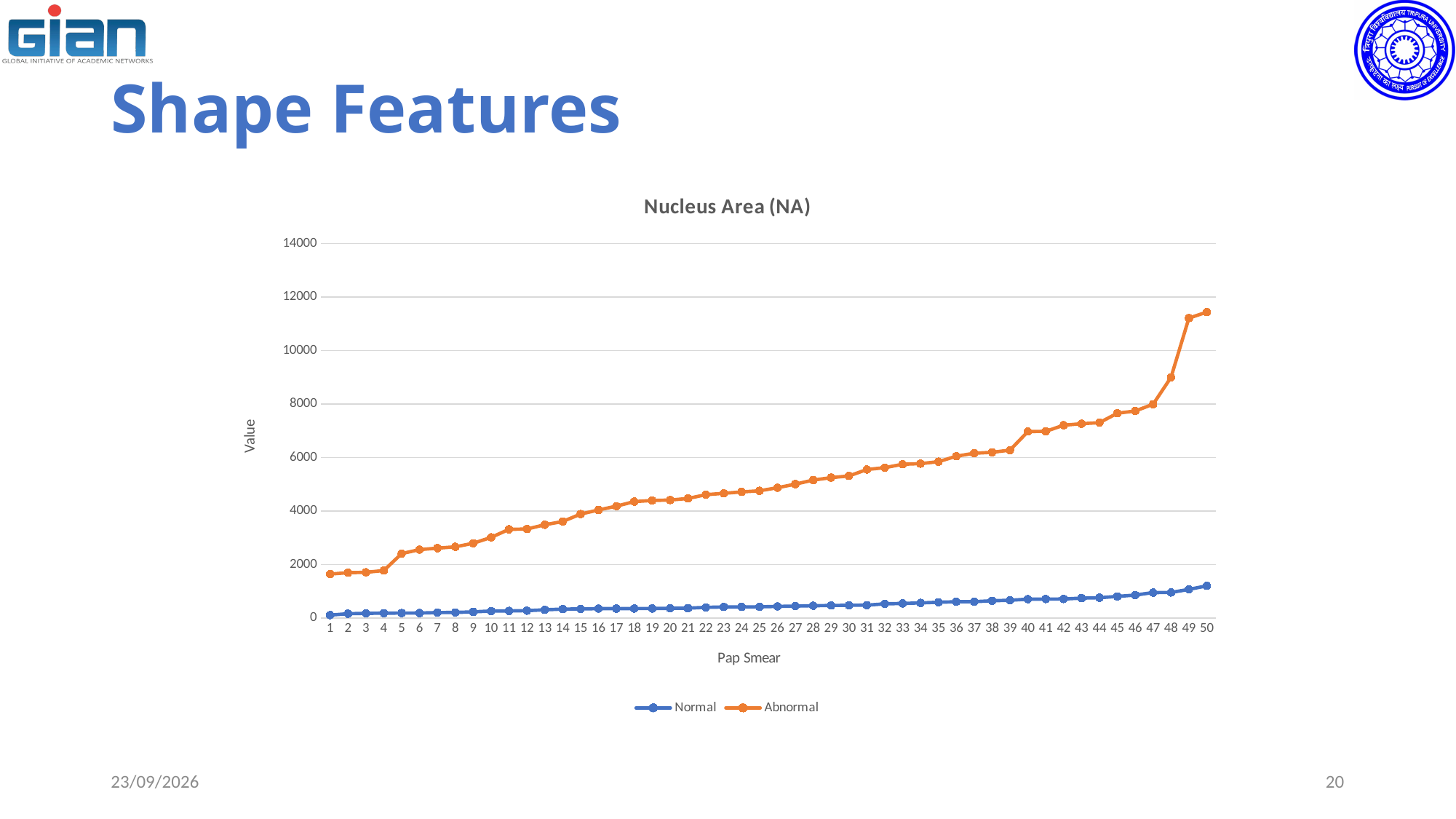
Do the Abnormal values rise or fall as Pap Smear goes from 1 to 50? rise What kind of chart is shown on the slide? line chart At which Pap Smear number is the Normal series lowest? 1 How many series does the legend list? 2 Is the Normal value at Pap Smear 50 greater or less than 2000? less Is the Abnormal value at Pap Smear 1 greater or less than 2000? less Which series has the higher value at Pap Smear 50, Normal or Abnormal? Abnormal How many Pap Smear points are plotted along the x axis? 50 What is the label of the y axis? Value At which Pap Smear number does the Abnormal series reach its highest value? 50 Is the Abnormal value at Pap Smear 50 greater or less than 10000? greater What is the title of the chart? Nucleus Area (NA)